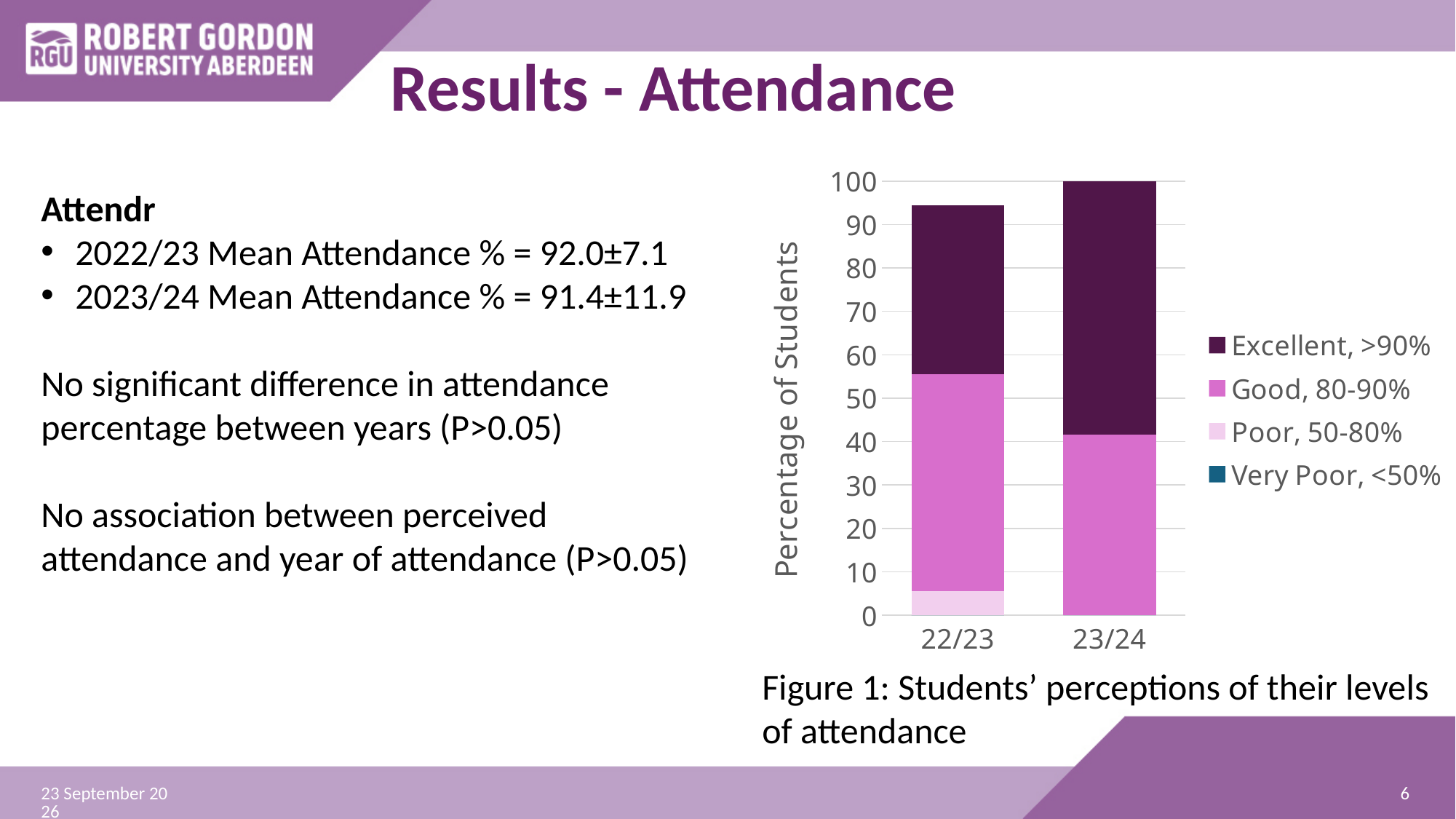
How many categories are shown on the x axis of the chart? 2 Is the 'Poor, 50-80%' segment for 22/23 greater or less than 10? less What is the label of the y axis of the chart? Percentage of Students Which year has the larger 'Good, 80-90%' segment, 22/23 or 23/24? 22/23 Does the 'Excellent, >90%' segment rise or fall from 22/23 to 23/24? rise Which year has the larger 'Excellent, >90%' segment, 22/23 or 23/24? 23/24 How many series does the chart's legend list? 4 Which year has the taller stacked bar overall? 23/24 What kind of chart is shown in Figure 1? Stacked bar chart Is the top of the stacked bar for 22/23 greater or less than 90? greater Is the 'Good, 80-90%' segment for 23/24 greater or less than 50? less Which legend entry is shown in the darkest purple colour? Excellent, >90%